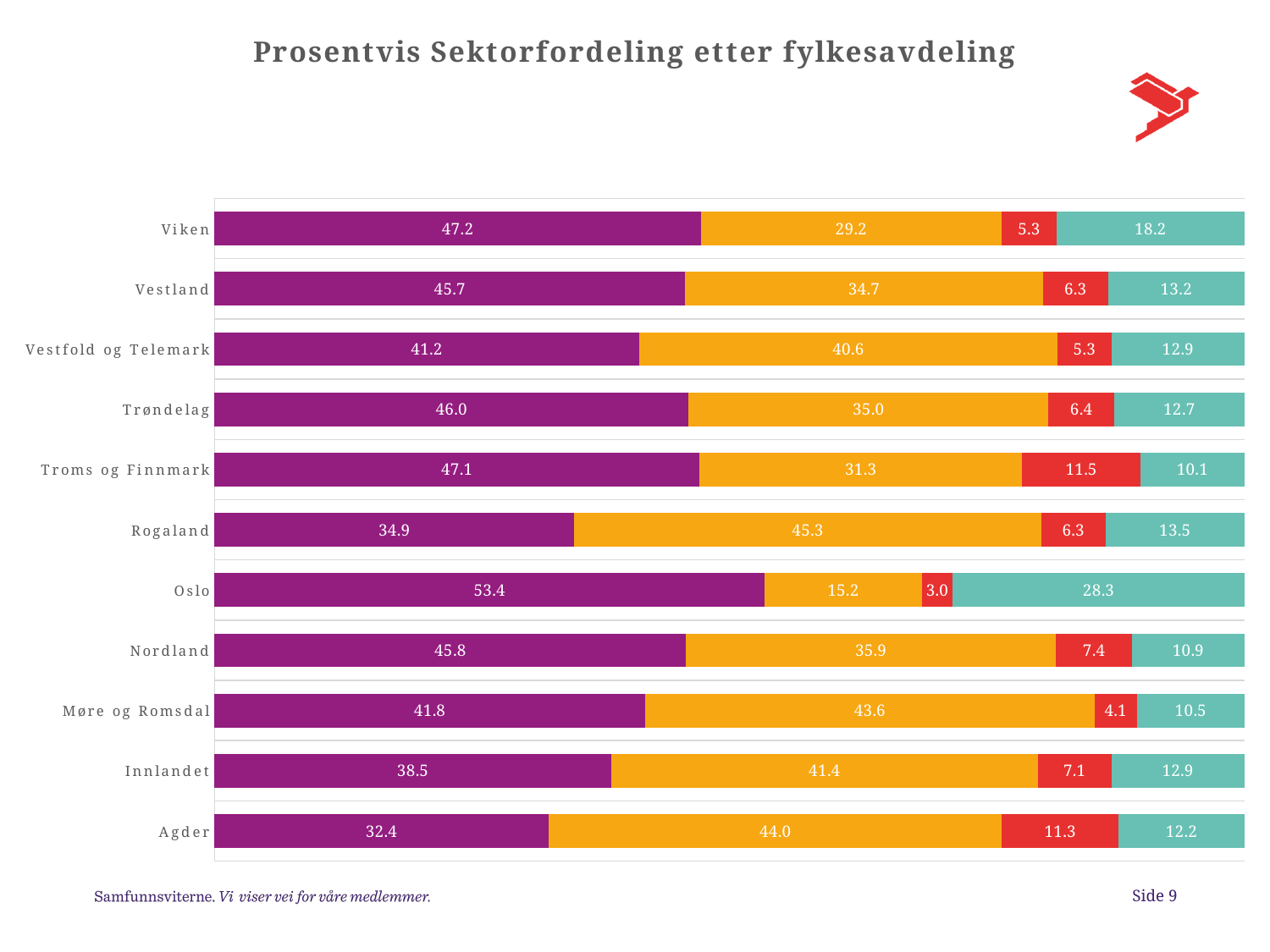
Which category has the largest purple segment? Oslo What is the value of the red segment for Møre og Romsdal? 4.1 What is the difference between the purple segment values for Viken and Vestland? 1.5 What is the title of the chart? Prosentvis Sektorfordeling etter fylkesavdeling Which category has the smallest purple segment? Agder What is the value of the teal segment for Viken? 18.2 Which has the larger orange segment, Rogaland or Agder? Rogaland What is the value of the purple segment for Oslo? 53.4 Which category has the smallest red segment? Oslo What kind of chart is shown on the slide? Stacked bar chart How many coloured segments does each bar in the chart have? 4 How many fylkesavdelinger (categories) are shown in the chart? 11